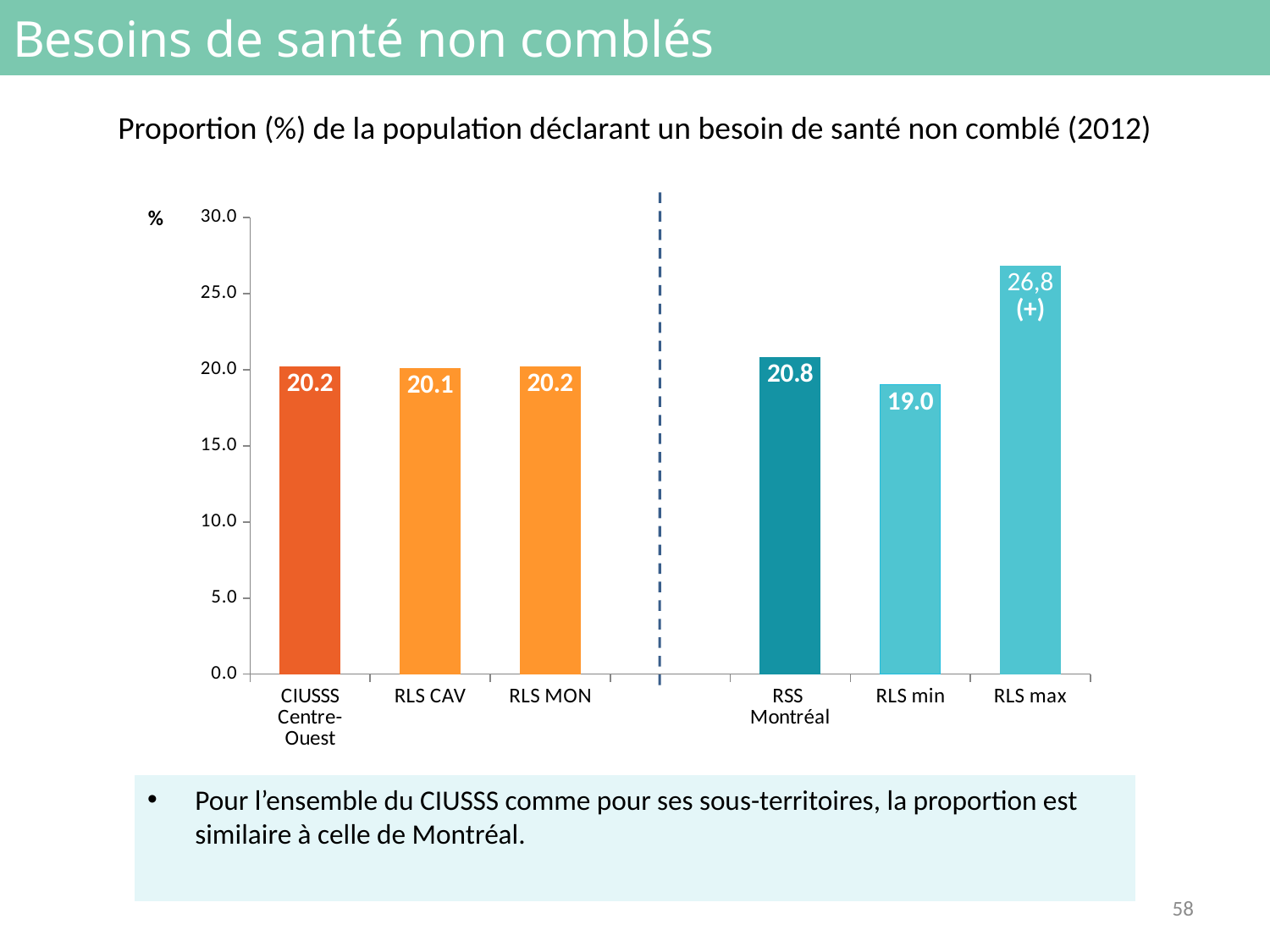
What kind of chart is shown on the slide? bar chart What is the difference between the values for RSS Montréal and CIUSSS Centre-Ouest? 0.6 How many bars are shown in the chart? 6 Is the value for RLS max greater or less than 25.0? greater Which is larger, the value for RSS Montréal or the value for RLS CAV? RSS Montréal What is the value for RLS CAV? 20.1 What is the data label shown on the RLS max bar? 26,8 (+) What is the value for CIUSSS Centre-Ouest? 20.2 What is the value for RLS min? 19.0 What is the value for RSS Montréal? 20.8 Which category has the lowest value? RLS min Which category has the highest value? RLS max